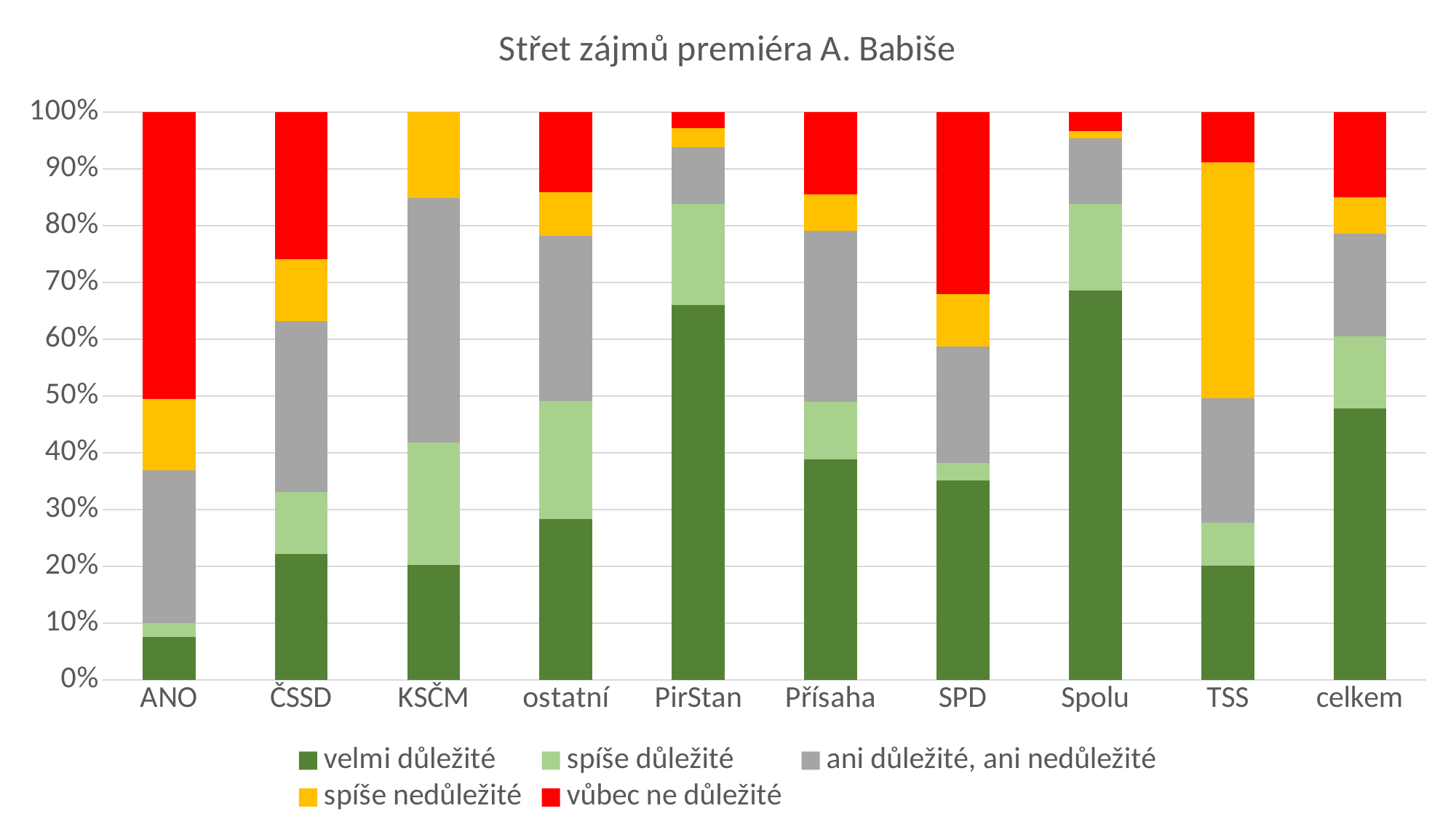
How many series does the legend list? 5 Is the 'velmi důležité' value for Spolu greater or less than 60%? greater Which category has the largest 'spíše nedůležité' segment? TSS Which category has the largest 'ani důležité, ani nedůležité' segment? KSČM How many categories are shown on the x axis? 10 What is the title of the chart? Střet zájmů premiéra A. Babiše Which is larger, the 'vůbec ne důležité' segment for ANO or for SPD? ANO What kind of chart is shown on the slide? stacked bar chart Which category has the smallest 'velmi důležité' segment? ANO Which category has the largest 'vůbec ne důležité' segment? ANO What is the total height of the stacked bar for celkem? 100% Is the 'velmi důležité' value for ANO greater or less than 10%? less